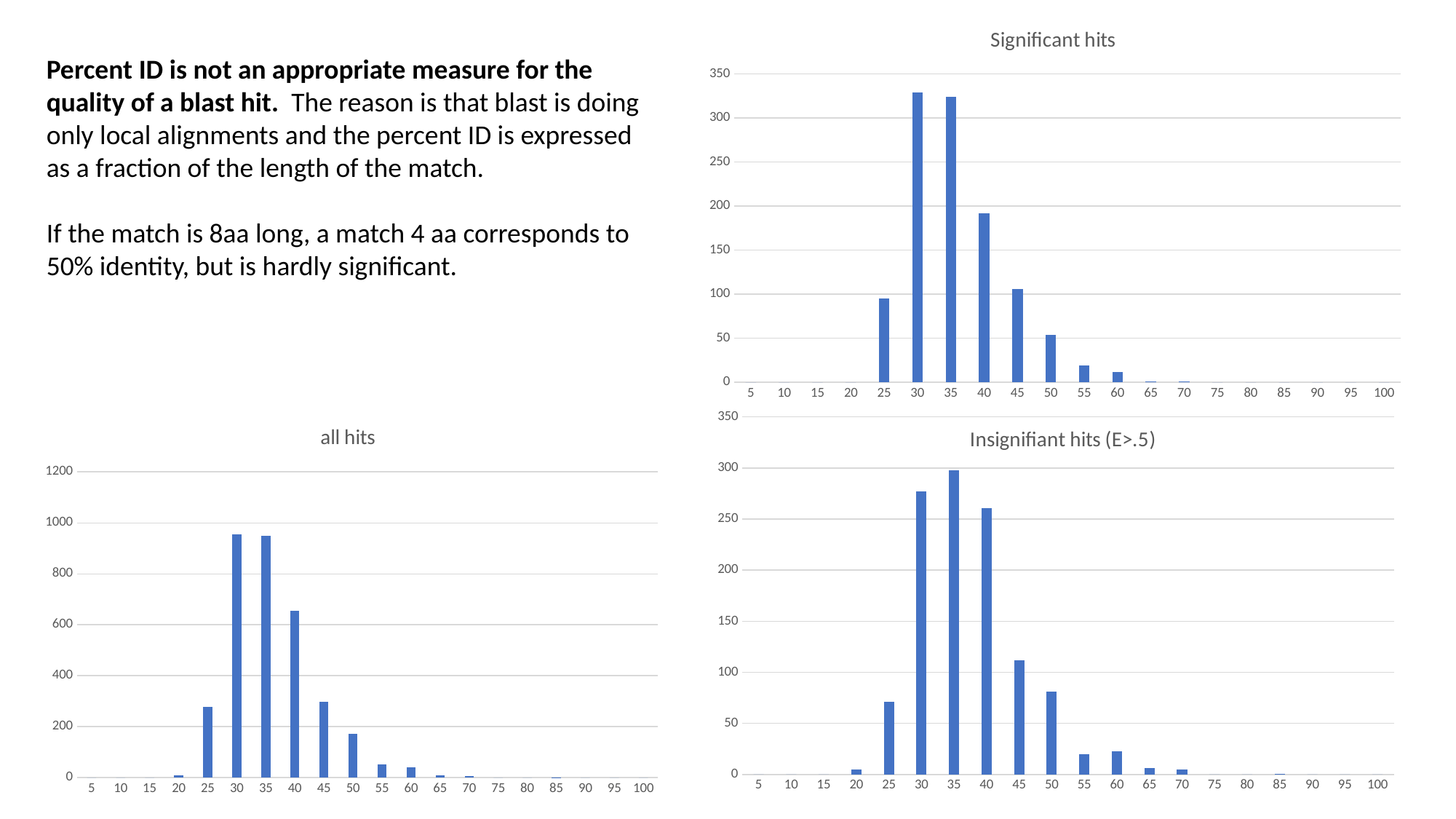
How many charts are shown on the slide? 3 In the 'Insignifiant hits (E>.5)' chart, is the value for 25 greater or less than 50? greater In the 'Insignifiant hits (E>.5)' chart, which is larger, the value for 30 or the value for 40? 30 In the 'Insignifiant hits (E>.5)' chart, is the value for 40 greater or less than 250? greater In the 'Significant hits' chart, which is larger, the value for 40 or the value for 45? 40 In the 'Insignifiant hits (E>.5)' chart, which category has the highest value? 35 In the 'all hits' chart, is the value for 40 greater or less than 600? greater What kind of chart is the 'Significant hits' chart? bar chart How many categories are shown on the x axis of the 'all hits' chart? 20